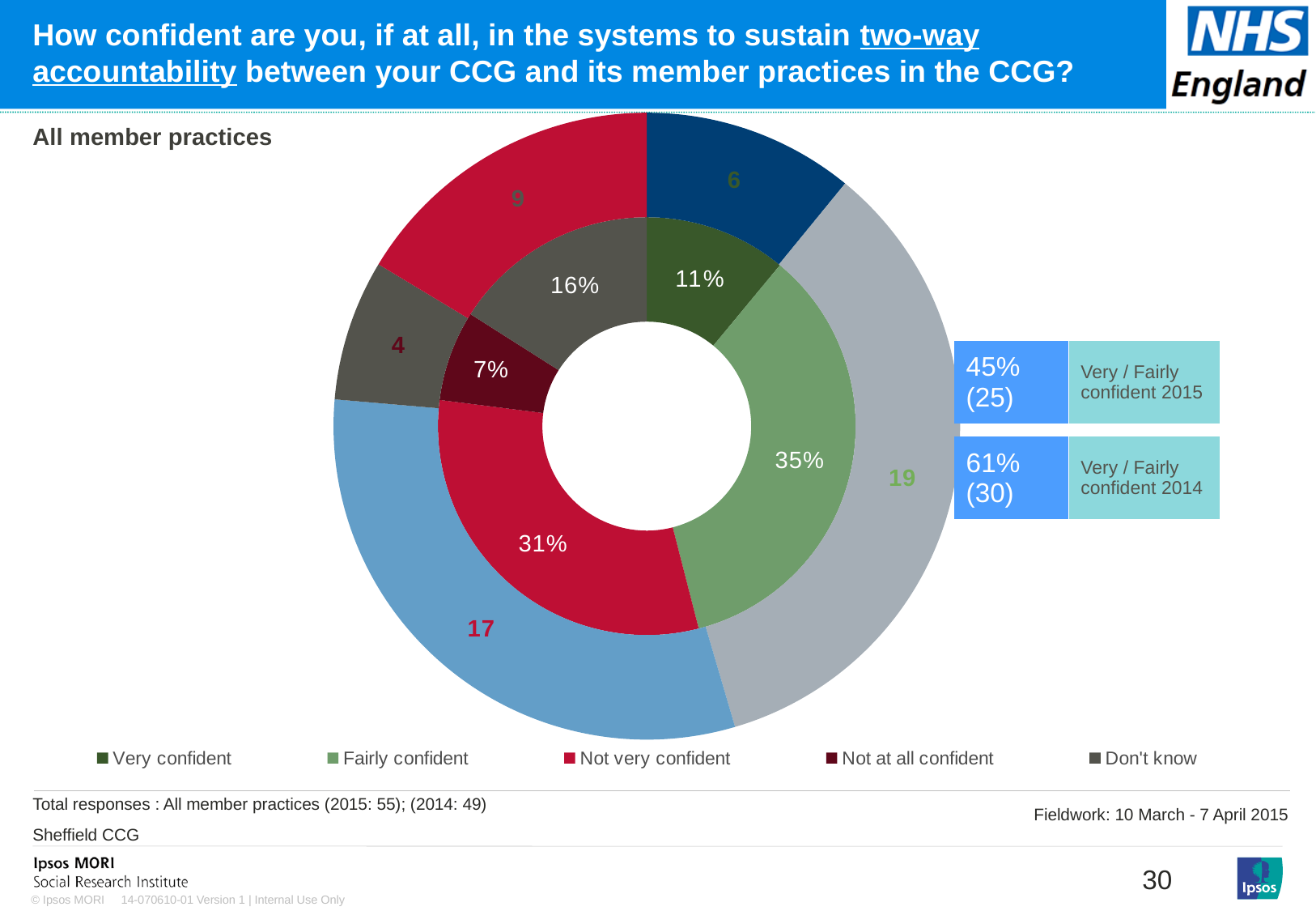
What is the difference in percentage points between 'Fairly confident' and 'Not very confident' in the inner ring? 4 percentage points Which response category has the smallest share in the inner ring? Not at all confident What is the combined percentage of 'Very confident' and 'Fairly confident' in 2015, as shown in the callout box? 45% (25) Which is larger in the inner ring: 'Not very confident' or 'Don't know'? Not very confident What percentage of member practices answered 'Don't know' according to the inner ring? 16% What percentage of member practices are 'Not at all confident' according to the inner ring? 7% How many response categories does the legend list? 5 What kind of chart is shown on the slide? Doughnut chart What was the 'Very / Fairly confident' figure in 2014, as shown in the callout box? 61% (30) What percentage of member practices are 'Very confident' according to the inner ring? 11% What percentage of member practices are 'Fairly confident' according to the inner ring? 35% Which response category has the largest share in the inner ring? Fairly confident